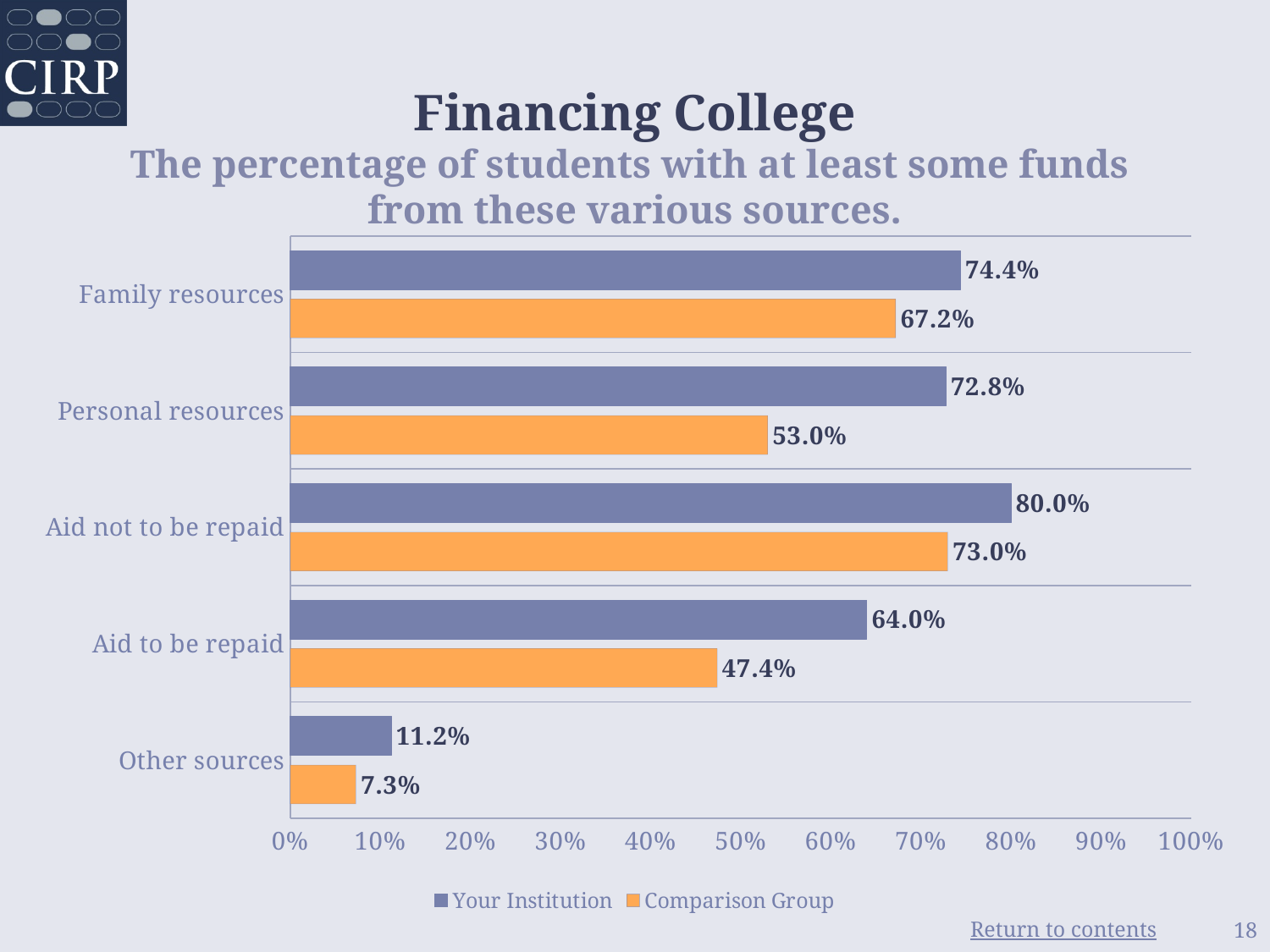
What kind of chart is shown on the slide? Bar chart Which category has the highest value for Your Institution? Aid not to be repaid Which colour represents the Comparison Group series? Orange How many categories are shown on the chart? 5 Which is larger for Personal resources: Your Institution or Comparison Group? Your Institution What is the value for Comparison Group for Other sources? 7.3% Which category has the lowest value for Comparison Group? Other sources What is the difference between Your Institution and Comparison Group for Aid to be repaid? 16.6% What is the value for Comparison Group for Personal resources? 53.0% Is the value for Comparison Group for Aid not to be repaid greater or less than 70%? greater What is the value for Your Institution for Family resources? 74.4% How many series does the legend list? 2